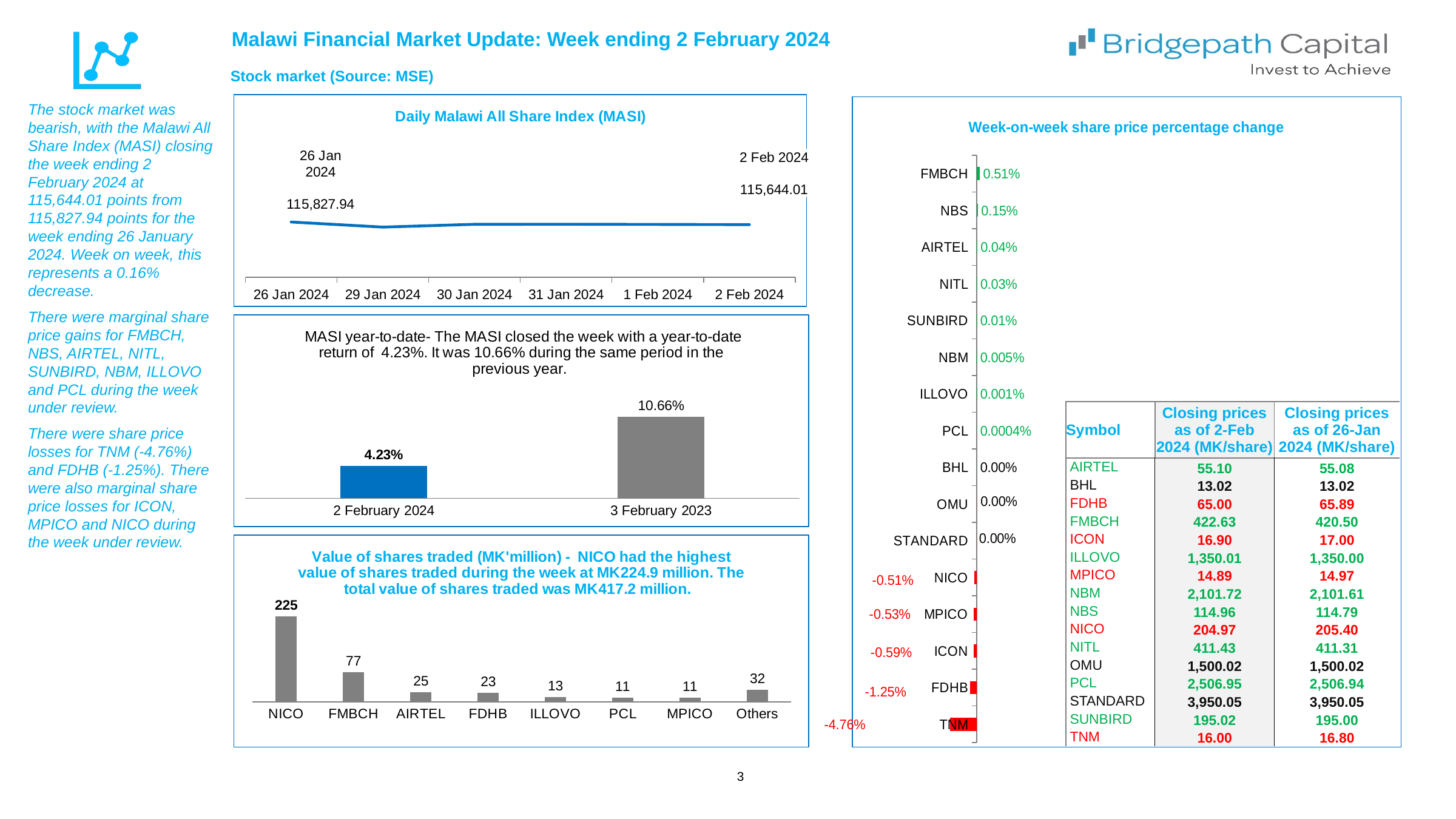
What kind of chart is the Daily Malawi All Share Index (MASI) chart? line chart On the MASI year-to-date chart, what is the difference between the 3 February 2023 value and the 2 February 2024 value? 6.43% How many categories are shown on the Value of shares traded chart? 8 On the MASI year-to-date chart, what is the year-to-date return shown for 2 February 2024? 4.23% On the MASI year-to-date chart, which date has the higher year-to-date return, 2 February 2024 or 3 February 2023? 3 February 2023 On the Value of shares traded chart, what is the difference between the NICO value and the FMBCH value? 148 On the Value of shares traded chart, what is the value shown for FMBCH? 77 On the Daily Malawi All Share Index (MASI) chart, what is the index value shown for 26 Jan 2024? 115,827.94 On the Value of shares traded chart, which category has the highest value? NICO On the Week-on-week share price percentage change chart, which company has the highest percentage change? FMBCH On the Daily Malawi All Share Index (MASI) chart, what is the index value shown for 2 Feb 2024? 115,644.01 On the Week-on-week share price percentage change chart, what is the value shown for TNM? -4.76%